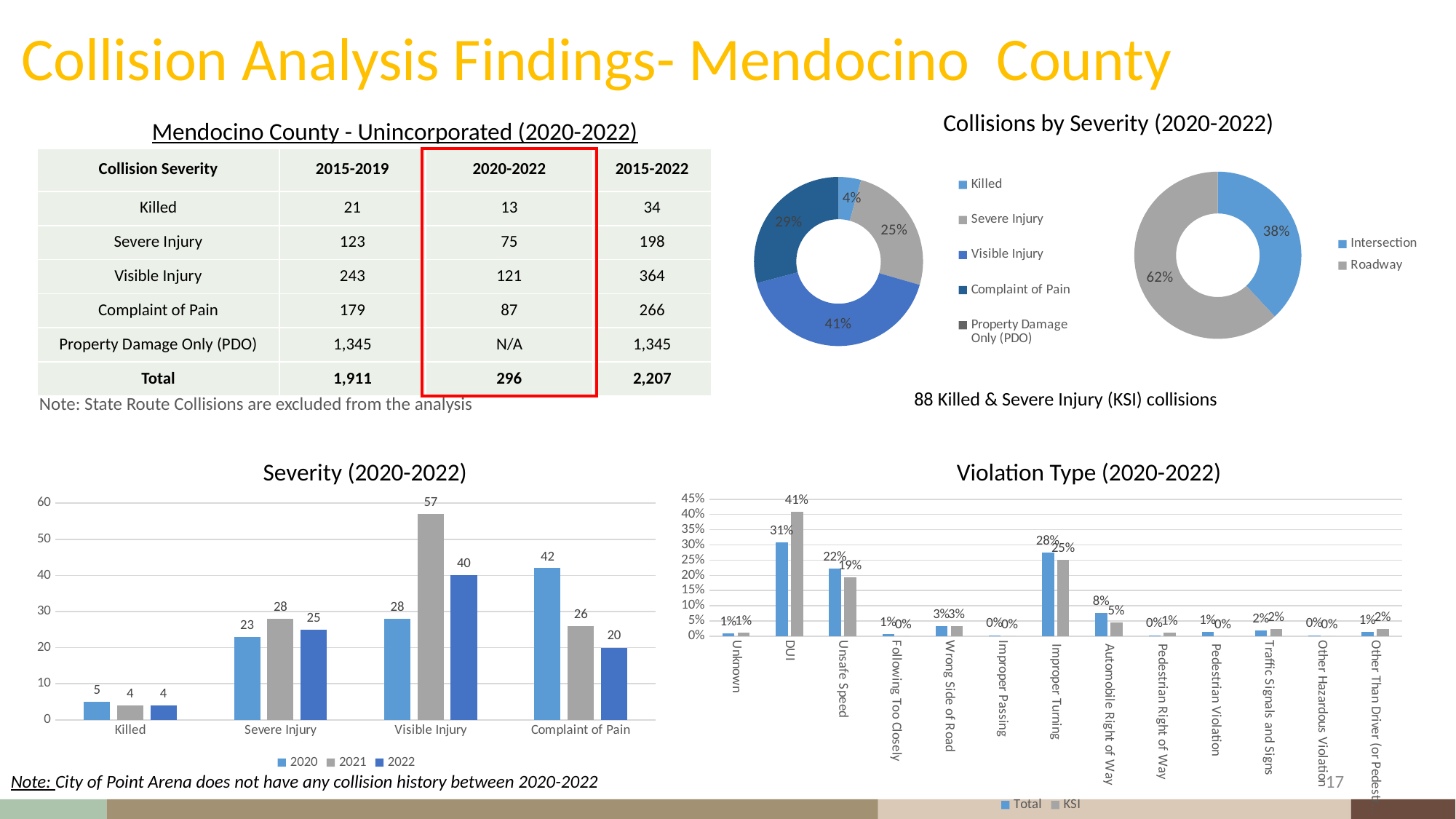
In the Collisions by Severity (2020-2022) pie chart, what share is Visible Injury? 41% In the Severity (2020-2022) bar chart, what is the value for Visible Injury in 2021? 57 In the Severity (2020-2022) bar chart, how many series does the legend list? 3 In the Intersection/Roadway donut chart on the right, what share is Roadway? 62% In the Collisions by Severity (2020-2022) pie chart, which category has the smallest slice? Killed What kind of chart is the Severity (2020-2022) chart? Bar chart In the Severity (2020-2022) bar chart, what is the difference between the 2020 and 2022 values for Complaint of Pain? 22 In the Violation Type (2020-2022) bar chart, how many violation type categories are shown on the x axis? 13 In the Severity (2020-2022) bar chart, which series is larger for Severe Injury, 2021 or 2022? 2021 In the Violation Type (2020-2022) bar chart, what is the KSI value for DUI? 41% In the Collisions by Severity (2020-2022) pie chart, how many entries does the legend list? 5 In the Violation Type (2020-2022) bar chart, which violation type has the highest Total value? DUI